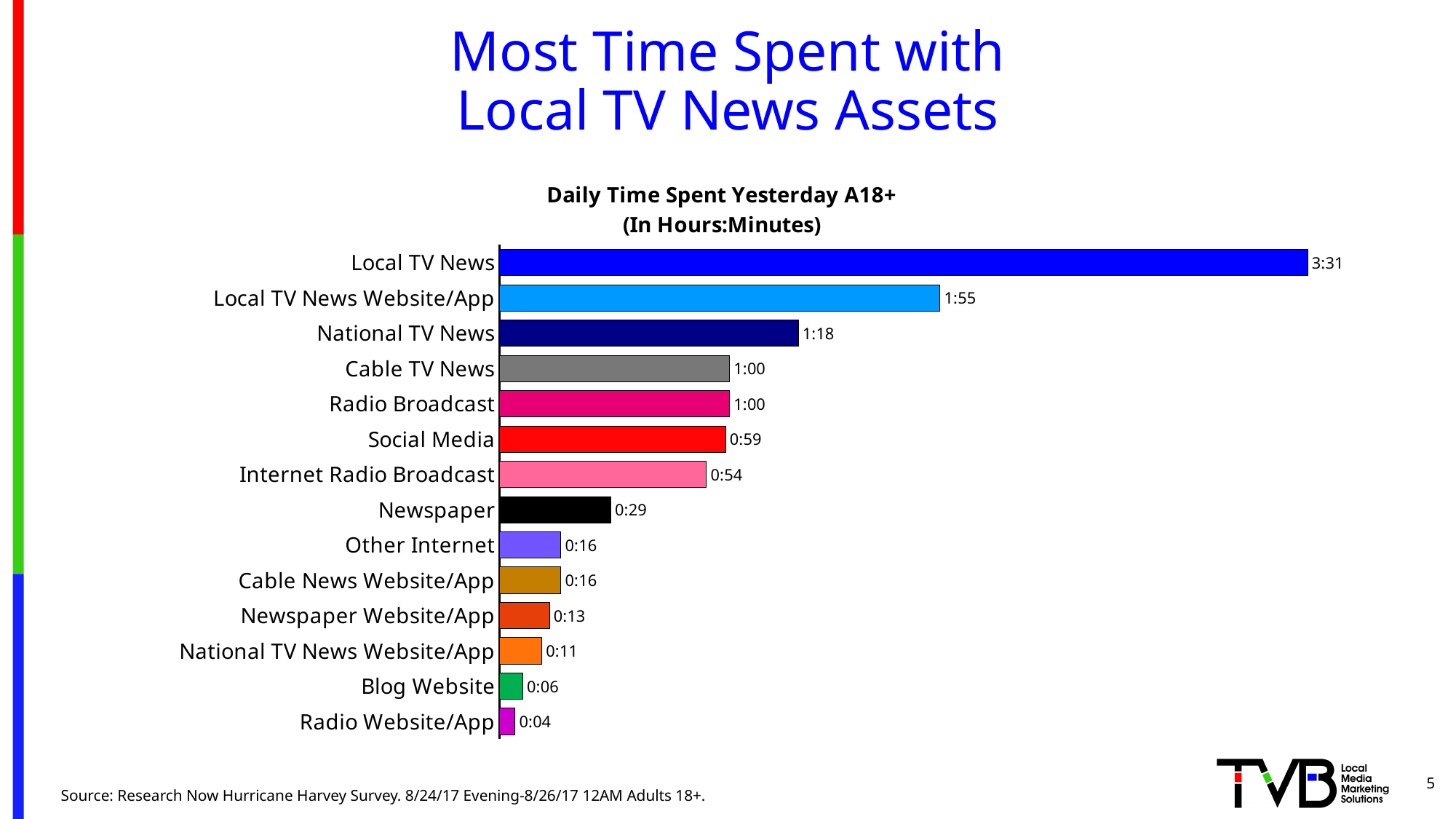
How much more time is spent with Local TV News than with Local TV News Website/App? 1:36 What is the daily time spent with Internet Radio Broadcast? 0:54 What is the title of the chart? Daily Time Spent Yesterday A18+ (In Hours:Minutes) Which has a larger daily time spent, Blog Website or Newspaper Website/App? Newspaper Website/App Which category has the lowest daily time spent? Radio Website/App Which has a larger daily time spent, Social Media or Newspaper? Social Media What is the daily time spent with Newspaper? 0:29 Which category has the highest daily time spent? Local TV News What is the difference in time spent between National TV News and Cable TV News? 0:18 How many categories are shown in the chart? 14 What is the daily time spent with Local TV News? 3:31 What type of chart is shown on the slide? Bar chart